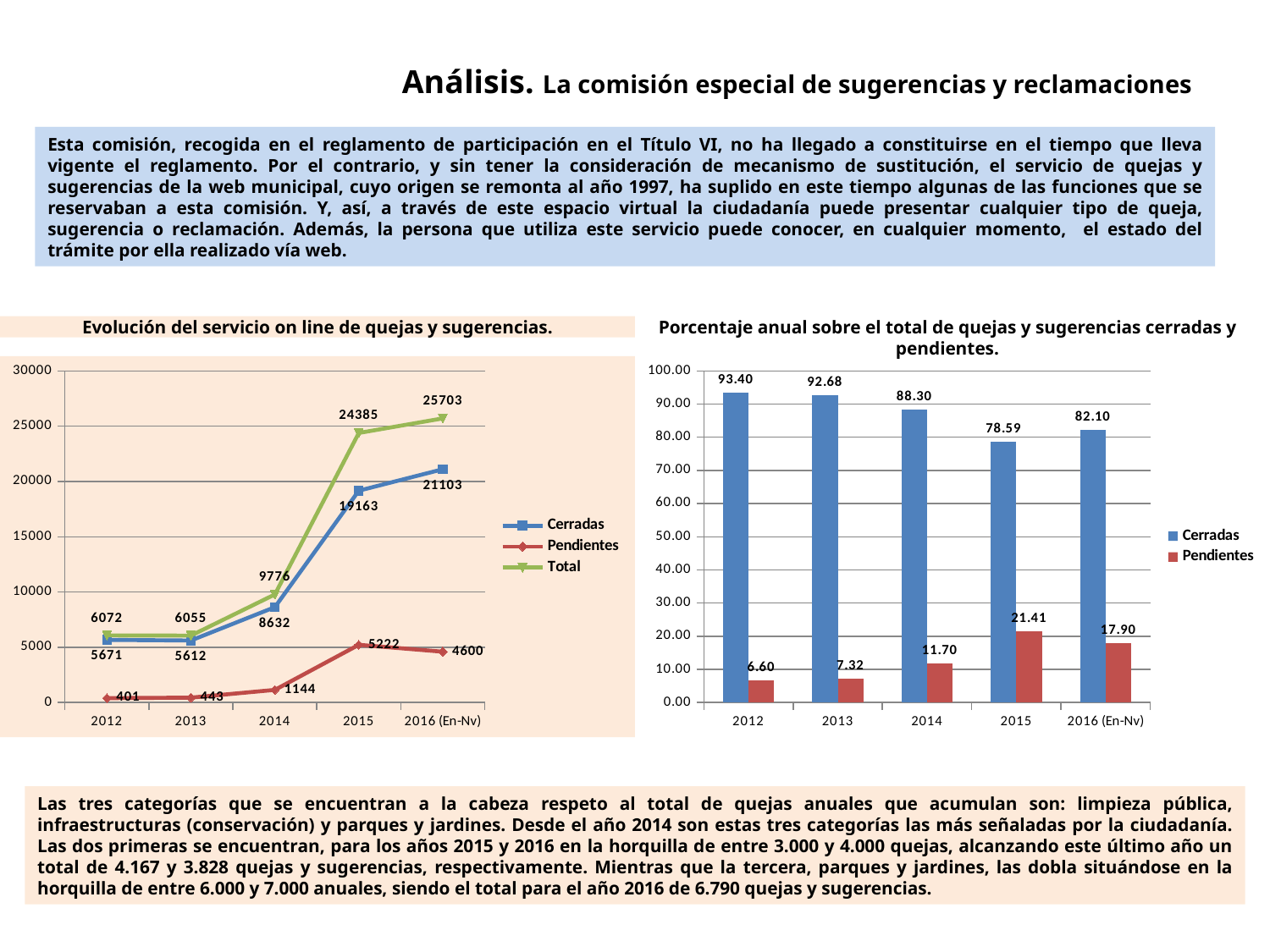
In the chart 'Porcentaje anual sobre el total de quejas y sugerencias cerradas y pendientes', which is larger: Cerradas in 2012 or Cerradas in 2016 (En-Nv)? Cerradas in 2012 In the chart 'Evolución del servicio on line de quejas y sugerencias', what is the difference between Cerradas in 2015 and Cerradas in 2014? 10531 In the chart 'Porcentaje anual sobre el total de quejas y sugerencias cerradas y pendientes', in which year is Pendientes highest? 2015 What type of chart is 'Porcentaje anual sobre el total de quejas y sugerencias cerradas y pendientes'? Bar chart In the chart 'Evolución del servicio on line de quejas y sugerencias', what is the value of Pendientes for 2014? 1144 What type of chart is 'Evolución del servicio on line de quejas y sugerencias'? Line chart In the chart 'Porcentaje anual sobre el total de quejas y sugerencias cerradas y pendientes', what is the value of Cerradas for 2014? 88.30 In the chart 'Evolución del servicio on line de quejas y sugerencias', in which year is Cerradas highest? 2016 (En-Nv) In the chart 'Porcentaje anual sobre el total de quejas y sugerencias cerradas y pendientes', how many years are shown on the x axis? 5 In the chart 'Evolución del servicio on line de quejas y sugerencias', what is the value of Total for 2015? 24385 In the chart 'Evolución del servicio on line de quejas y sugerencias', how many series does the legend list? 3 In the chart 'Evolución del servicio on line de quejas y sugerencias', in which year is Pendientes lowest? 2012